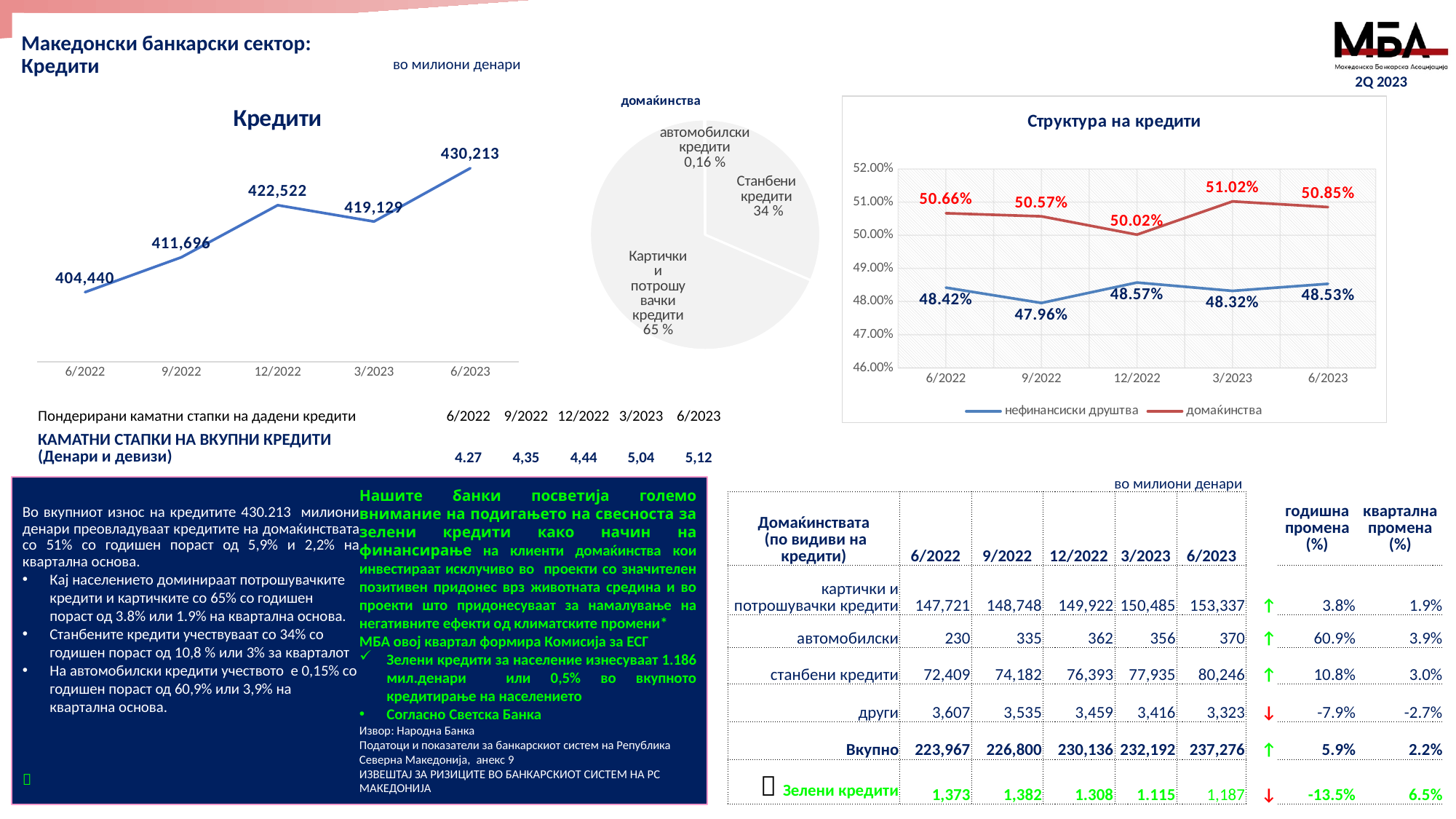
In the 'домаќинства' pie chart, what share do 'Станбени кредити' have? 34 % In the 'Структура на кредити' chart, which series has the higher value in 9/2022, 'домаќинства' or 'нефинансиски друштва'? домаќинства What type of chart is the 'Кредити' chart? Line chart In the 'Кредити' chart, which period has the highest value? 6/2023 In the 'Кредити' chart, which period has the lowest value? 6/2022 In the 'Кредити' chart, what is the value for 6/2023? 430,213 In the 'Кредити' chart, what is the difference between the values for 6/2023 and 6/2022? 25,773 In the 'Структура на кредити' chart, in which period is the value for 'нефинансиски друштва' lowest? 9/2022 In the 'домаќинства' pie chart, which slice is the largest? Картички и потрошувачки кредити How many series does the legend of the 'Структура на кредити' chart list? 2 How many data points are plotted in the 'Кредити' chart? 5 In the 'Структура на кредити' chart, what is the value for 'домаќинства' in 3/2023? 51.02%